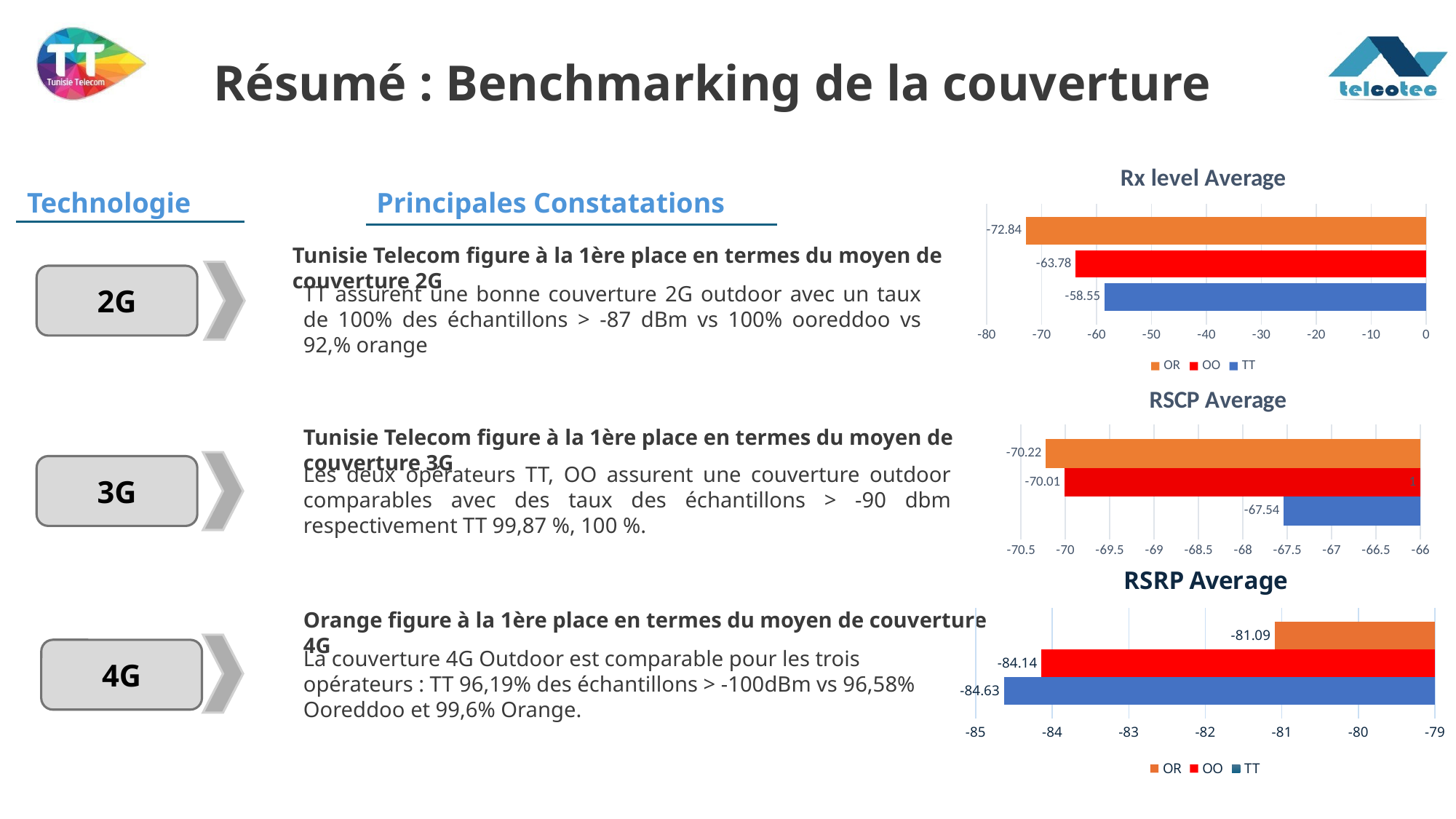
In the RSRP Average chart, which operator has the highest (least negative) value? OR In the RSRP Average chart, which is larger, the value for OO or the value for TT? OO In the Rx level Average chart, which operator has the lowest (most negative) value? OR What kind of chart is the RSCP Average chart? Bar chart In the RSRP Average chart, what is the value for TT? -84.63 How many series does the legend of the Rx level Average chart list? 3 In the Rx level Average chart, what is the value for TT? -58.55 In the Rx level Average chart, what is the difference between the values for TT and OR? 14.29 In the RSCP Average chart, which operator has the highest (least negative) value? TT In the RSCP Average chart, what is the value for OO? -70.01 In the RSRP Average chart, what is the difference between the values for OR and TT? 3.54 In the Rx level Average chart, what is the value for OR? -72.84